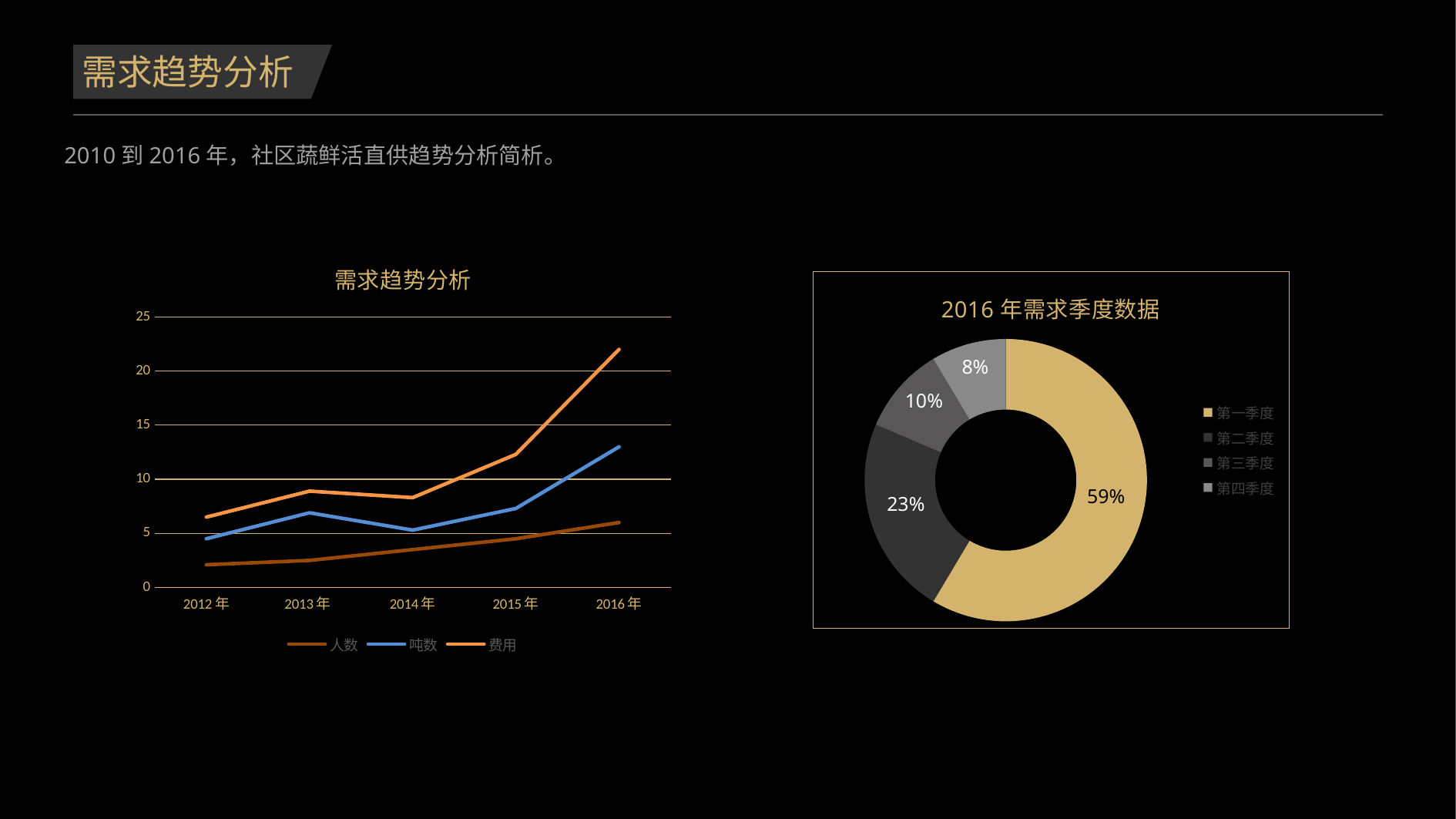
In the chart titled 需求趋势分析, which series has the highest value in 2016 年? 费用 In the chart titled 需求趋势分析, how many series does the legend list? 3 In the chart titled 需求趋势分析, is the value for 吨数 in 2016 年 greater or less than 10? greater In the chart titled 2016 年需求季度数据, what share does 第一季度 have? 59% What kind of chart is the chart titled 需求趋势分析? line chart In the chart titled 2016 年需求季度数据, which quarter has the smallest share? 第四季度 In the chart titled 需求趋势分析, how many years are shown on the x axis? 5 In the chart titled 需求趋势分析, does the 费用 series rise or fall from 2012 年 to 2016 年? rise In the chart titled 需求趋势分析, is the value for 费用 in 2016 年 greater or less than 20? greater In the chart titled 2016 年需求季度数据, what is the difference between the shares of 第二季度 and 第三季度? 13% What kind of chart is the chart titled 2016 年需求季度数据? pie chart (donut) In the chart titled 需求趋势分析, is the value for 费用 in 2015 年 greater or less than 10? greater